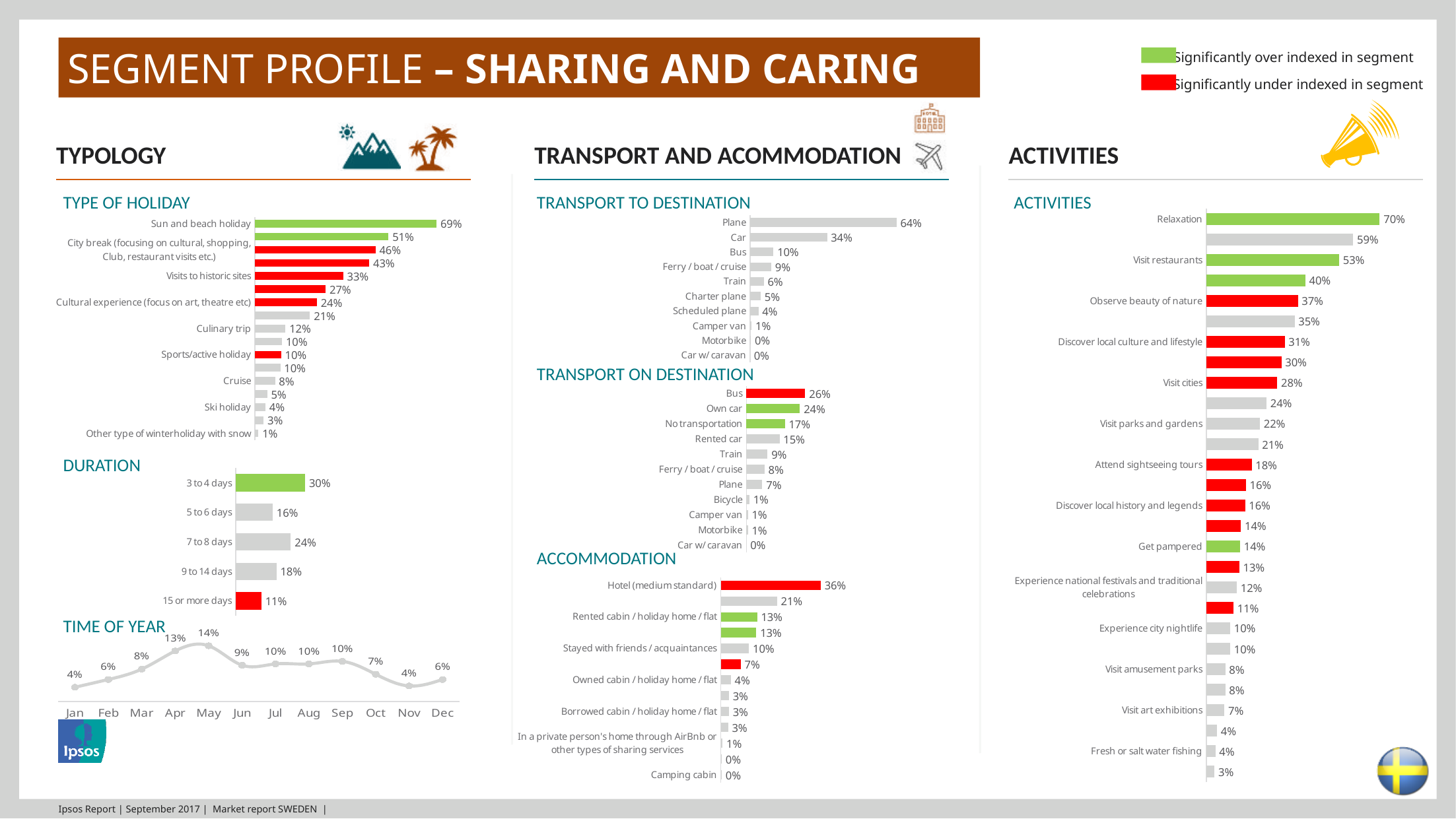
In the Type of Holiday chart, what is the value for Visits to historic sites? 33% In the Activities chart, what is the value for Relaxation? 70% In the Time of Year chart, which month has the highest value? May In the Duration chart, which duration category has the lowest value? 15 or more days In the Transport on Destination chart, which is larger: Own car or Rented car? Own car What kind of chart is the Time of Year chart? Line chart In the Accommodation chart, what is the value for Hotel (medium standard)? 36% In the Duration chart, how many duration categories are shown? 5 In the Transport on Destination chart, which category has the highest value? Bus In the Duration chart, what is the value for 3 to 4 days? 30% In the Transport to Destination chart, what is the difference between Plane and Car? 30% In the Transport to Destination chart, what is the value for Plane? 64%